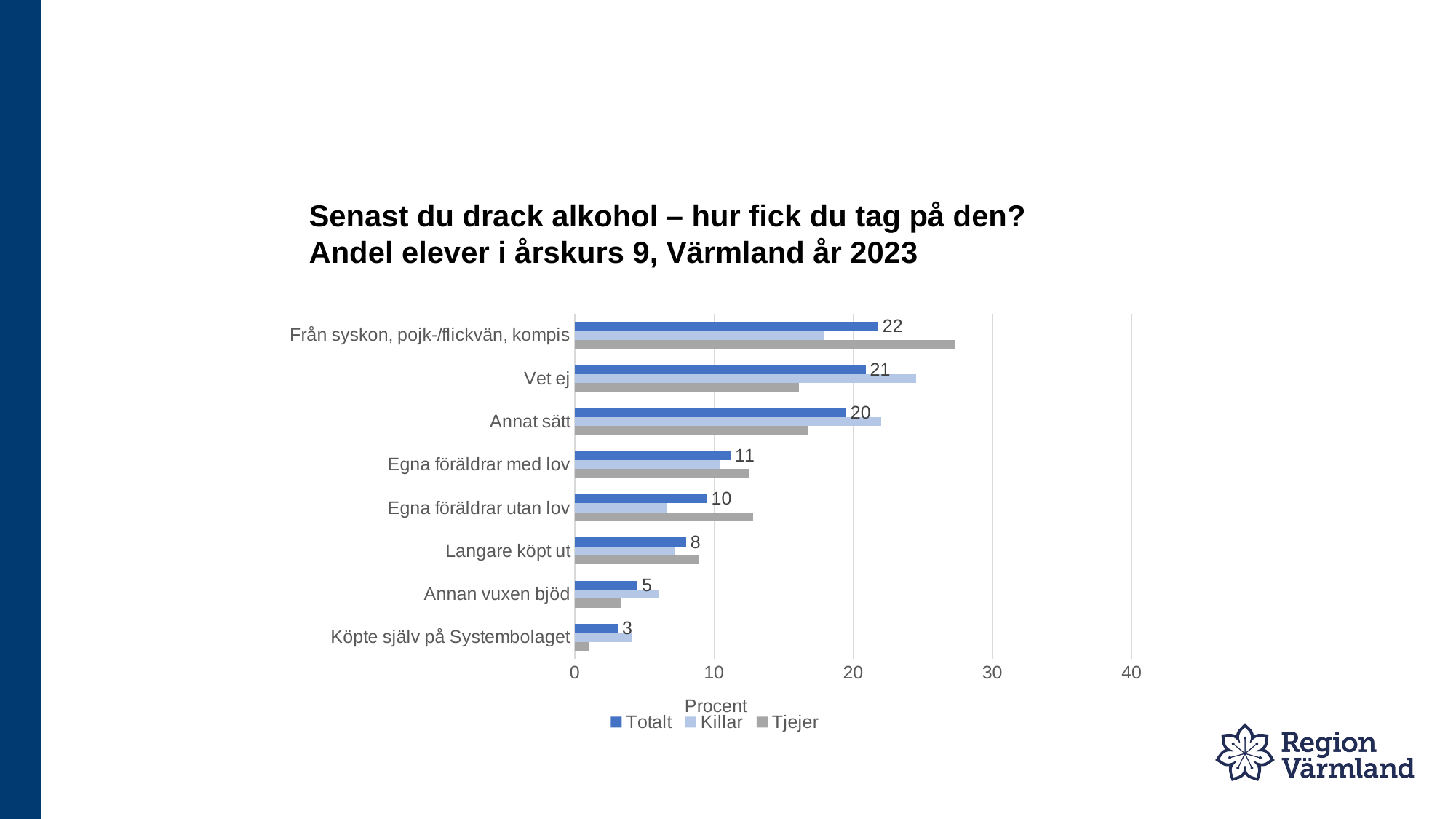
Which category has the highest Totalt value? Från syskon, pojk-/flickvän, kompis What kind of chart is shown on the slide? Bar chart Which category has the lowest Totalt value? Köpte själv på Systembolaget How many categories are shown on the chart? 8 What is the Totalt value for "Från syskon, pojk-/flickvän, kompis"? 22 Is the Tjejer value for "Från syskon, pojk-/flickvän, kompis" greater or less than 20? greater What is the Totalt value for "Köpte själv på Systembolaget"? 3 For "Vet ej", which is larger: the Killar value or the Tjejer value? Killar What is the difference between the Totalt values for "Vet ej" and "Langare köpt ut"? 13 For "Från syskon, pojk-/flickvän, kompis", which is larger: the Killar value or the Tjejer value? Tjejer What is the Totalt value for "Egna föräldrar utan lov"? 10 How many series does the legend list? 3